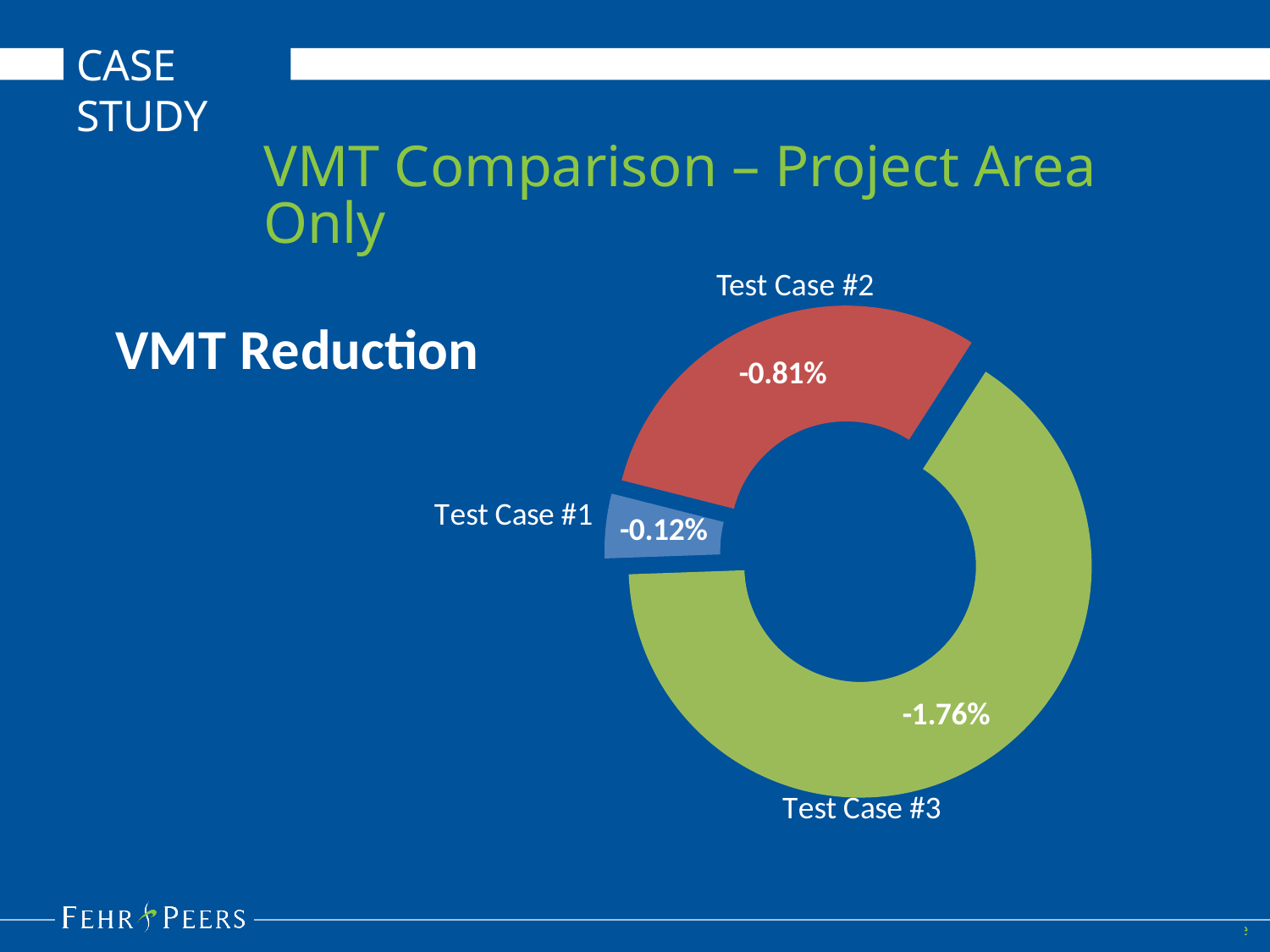
What is the VMT reduction value shown for Test Case #2? -0.81% How many test cases are shown in the chart? 3 By how many percentage points does the VMT reduction for Test Case #3 exceed that of Test Case #2? 0.95 percentage points What colour is the slice for Test Case #3? Green Which test case has the largest VMT reduction (the largest slice of the chart)? Test Case #3 By how many percentage points does the VMT reduction for Test Case #2 exceed that of Test Case #1? 0.69 percentage points What is the title of the slide containing the chart? VMT Comparison – Project Area Only Which test case has the smallest VMT reduction (the smallest slice of the chart)? Test Case #1 What is the VMT reduction value shown for Test Case #1? -0.12% What is the VMT reduction value shown for Test Case #3? -1.76% What kind of chart is used to show the VMT reduction values? Doughnut (pie) chart Which has the larger VMT reduction, Test Case #1 or Test Case #2? Test Case #2